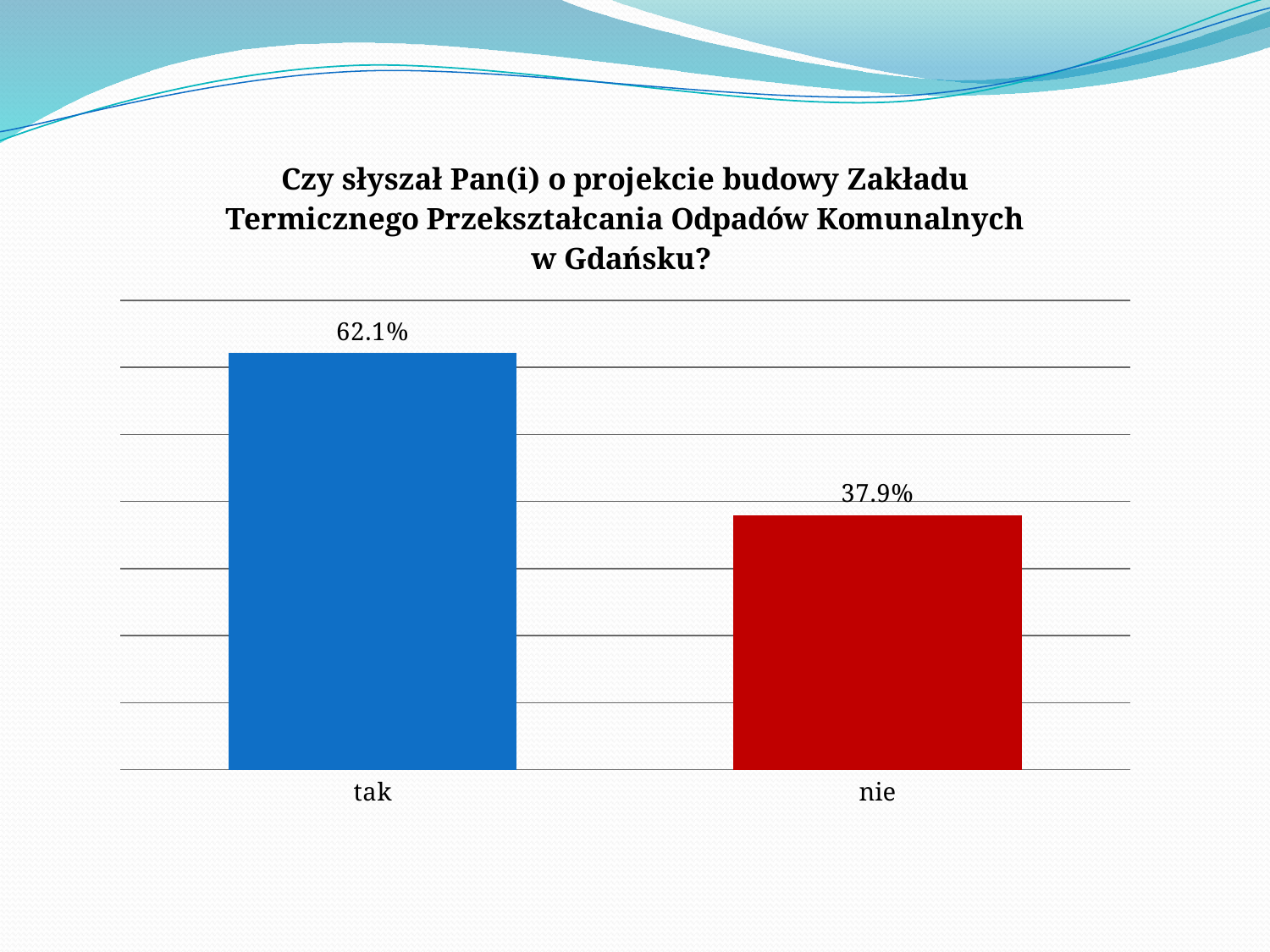
Which category has the lowest value? nie What is the total of the two values shown? 100% What colour is the bar for "nie"? red What is the value for "nie"? 37.9% What colour is the bar for "tak"? blue What is the difference between the values for "tak" and "nie"? 24.2% How many categories are shown on the x axis? 2 What kind of chart is shown on the slide? bar chart Which category has the highest value? tak What is the value for "tak"? 62.1% Which is larger, the value for "tak" or the value for "nie"? tak